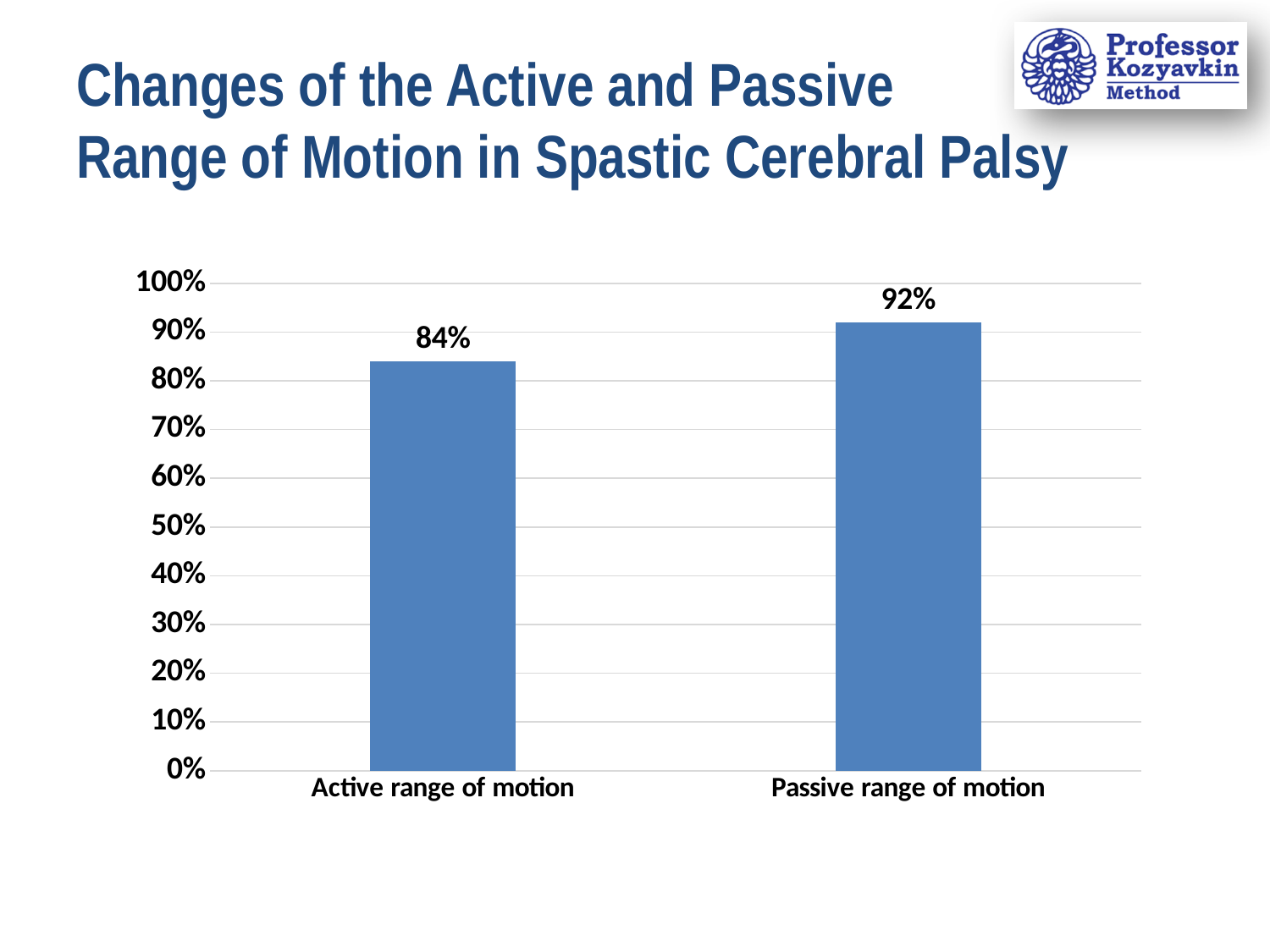
What is the difference between the values for Passive range of motion and Active range of motion? 8% Is the value for Active range of motion greater or less than 80%? greater What is the value for Active range of motion? 84% Which category has the highest value? Passive range of motion What kind of chart is shown on the slide? Bar chart Which category has the lowest value? Active range of motion Which is larger, the value for Active range of motion or the value for Passive range of motion? Passive range of motion What is the title of the slide containing the chart? Changes of the Active and Passive Range of Motion in Spastic Cerebral Palsy Is the value for Passive range of motion greater or less than 100%? less What is the value for Passive range of motion? 92% How many categories are shown on the chart? 2 Do the values rise or fall from Active range of motion to Passive range of motion? Rise